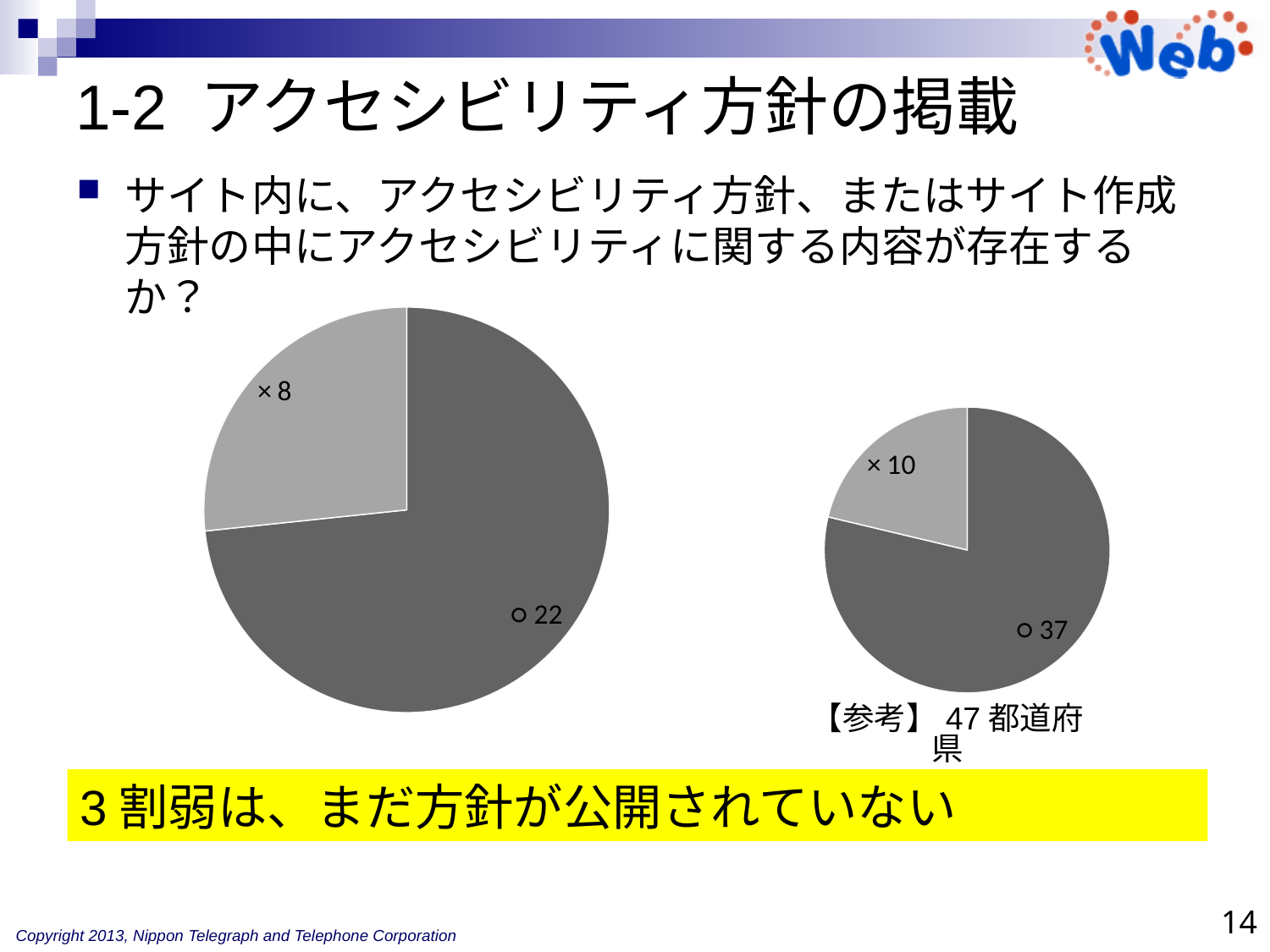
In the right pie chart (【参考】47都道府県), what is the value for the ○ slice? 37 In the left pie chart, which slice is larger, ○ or ×? ○ In the right pie chart, what is the difference between the ○ value and the × value? 27 What kind of charts are shown on the slide? Pie charts In the right pie chart, which slice is the smallest? × What is the total of the two slices in the left pie chart? 30 In the right pie chart (【参考】47都道府県), what is the value for the × slice? 10 In the left pie chart, what is the value for the ○ slice? 22 How many slices does each pie chart have? 2 In the left pie chart, what is the difference between the ○ value and the × value? 14 What caption is shown below the right pie chart? 【参考】47都道府県 In the left pie chart, what is the value for the × slice? 8